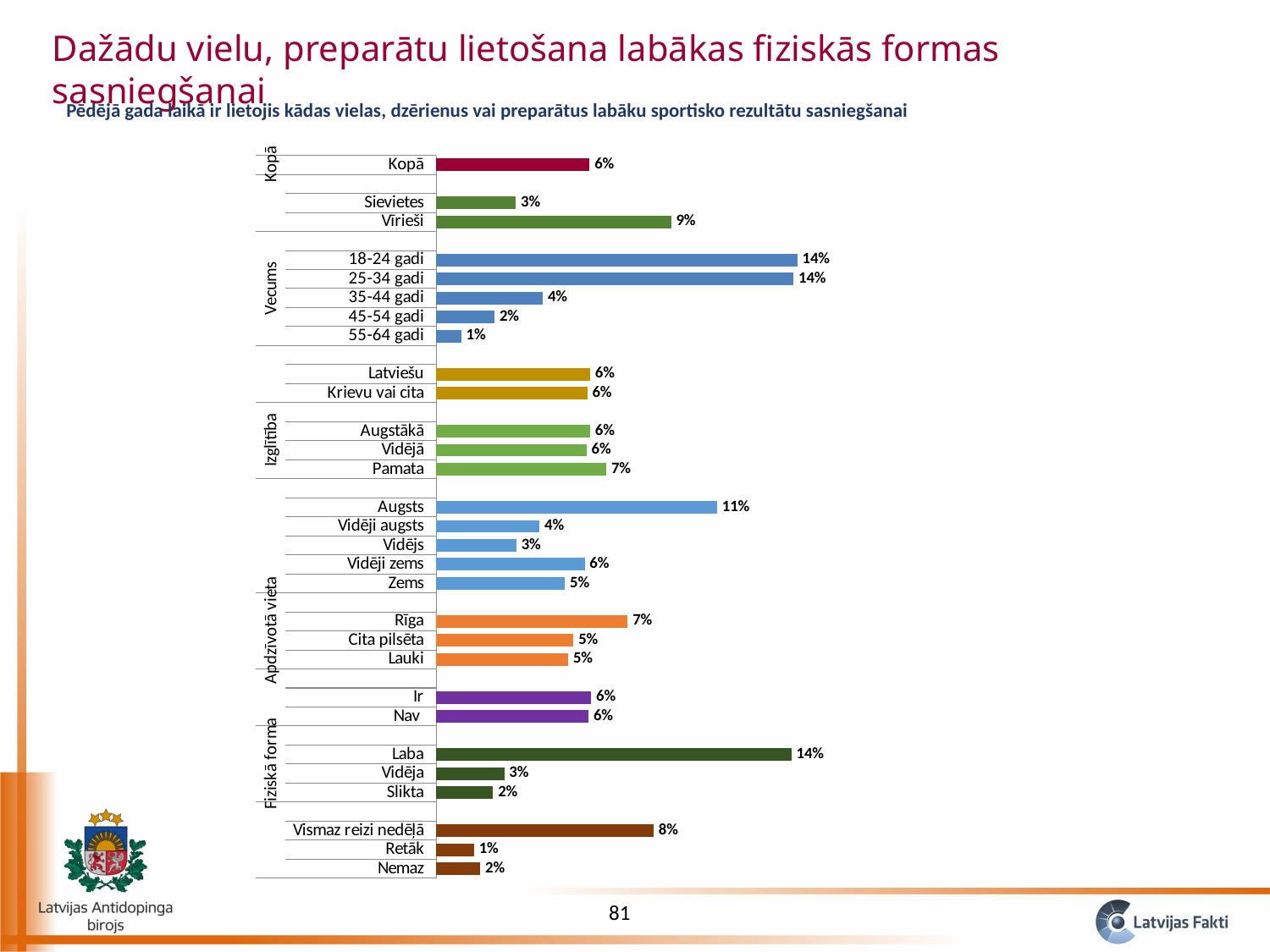
Among the Apdzīvotā vieta categories (Rīga, Cita pilsēta, Lauki), which has the highest value? Rīga Which has a larger value, Augsts or Zems? Augsts What is the value for Vīrieši? 9% What is the value for Augsts? 11% Among the Fiziskā forma categories (Laba, Vidēja, Slikta), which has the highest value? Laba What kind of chart is shown on the slide? bar chart What is the value for the 55-64 gadi group? 1% What is the difference between the values for Vīrieši and Sievietes? 6 percentage points What is the value for Kopā? 6% What is the value for Vismaz reizi nedēļā? 8% Among the Vecums age groups, which has the lowest value? 55-64 gadi How many bars are plotted in the chart? 29